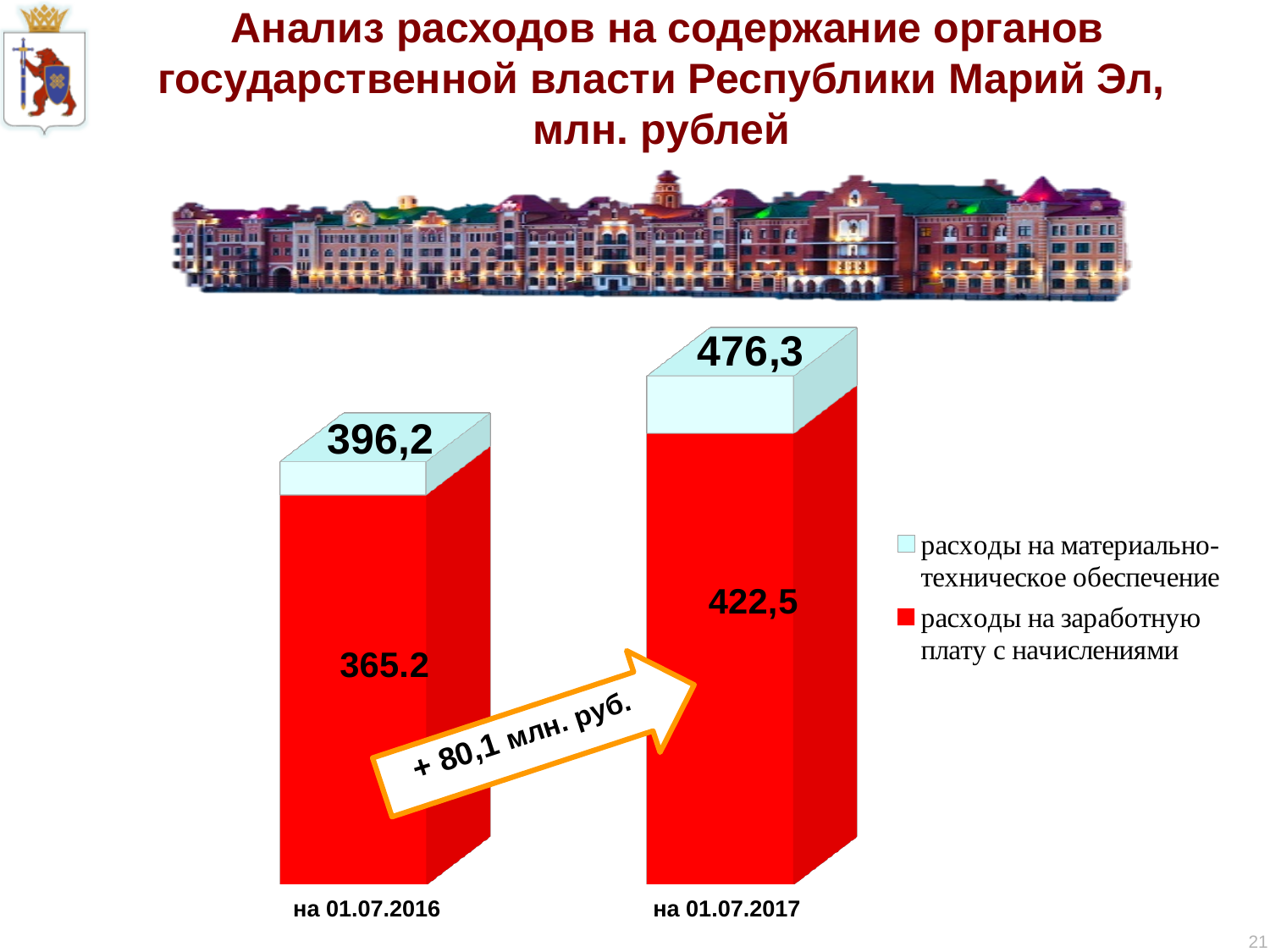
What is the difference between the расходы на заработную плату с начислениями values for на 01.07.2017 and на 01.07.2016? 57,3 How many series does the legend list? 2 What is the value of расходы на заработную плату с начислениями for на 01.07.2017? 422,5 What kind of chart is shown on the slide? Stacked bar chart By how much does the total for на 01.07.2017 exceed the total for на 01.07.2016? 80,1 Which category has the higher total, на 01.07.2016 or на 01.07.2017? на 01.07.2017 What is the total shown on top of the bar for на 01.07.2016? 396,2 Do the totals rise or fall from на 01.07.2016 to на 01.07.2017? Rise What is the total shown on top of the bar for на 01.07.2017? 476,3 What is the value of расходы на заработную плату с начислениями for на 01.07.2016? 365.2 How many categories are shown on the x axis? 2 Which category has the lowest total? на 01.07.2016